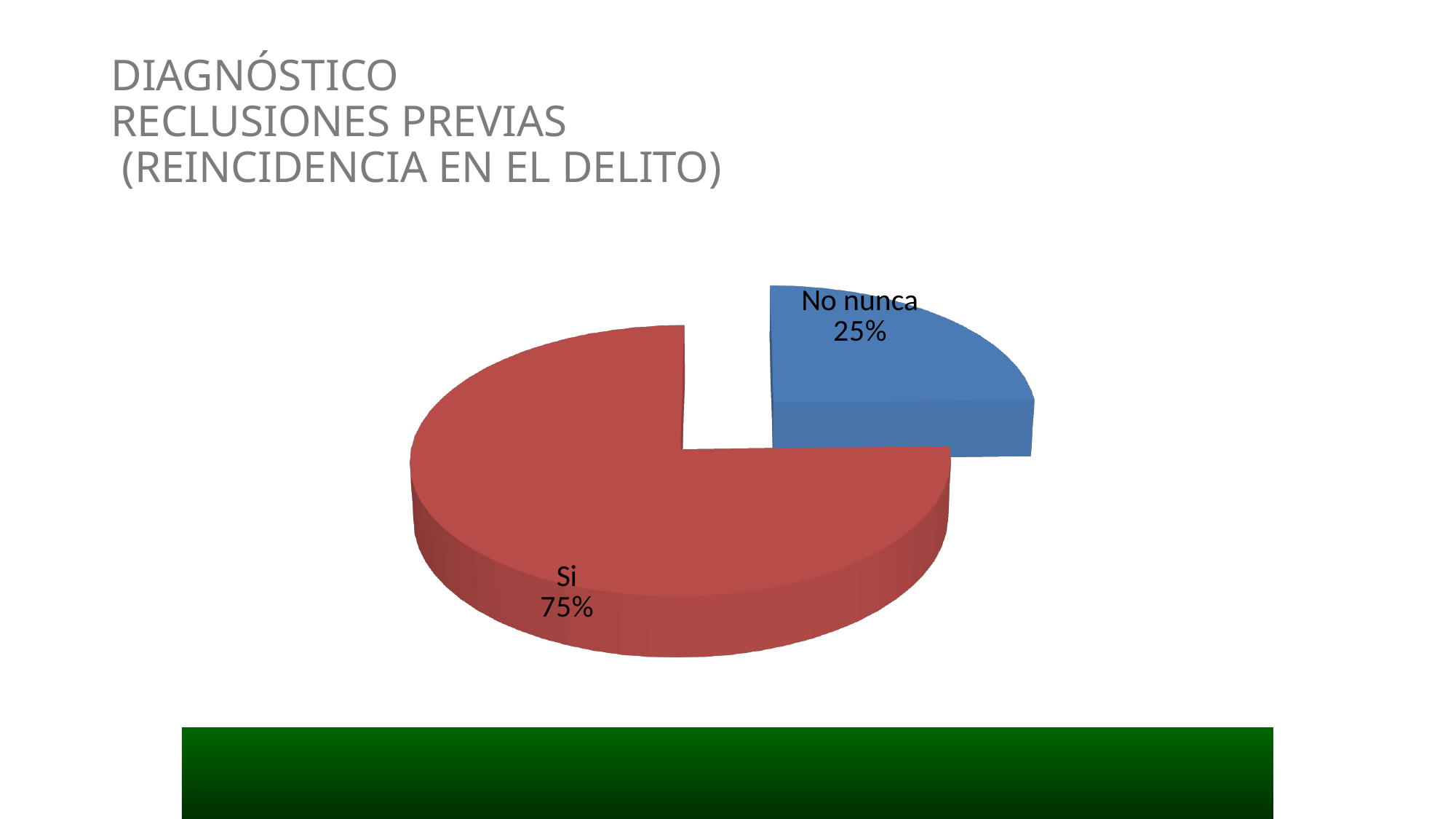
How many slices does the pie chart have? 2 What share of the pie does the "Si" slice represent? 75% Which slice is larger, "Si" or "No nunca"? Si What colour is the "No nunca" slice? Blue Which slice is the smallest in the pie chart? No nunca What is the difference in percentage points between the "Si" and "No nunca" slices? 50 What colour is the "Si" slice? Red What share of the pie does the "No nunca" slice represent? 25% What kind of chart is shown on the slide? Pie chart Which slice is the largest in the pie chart? Si